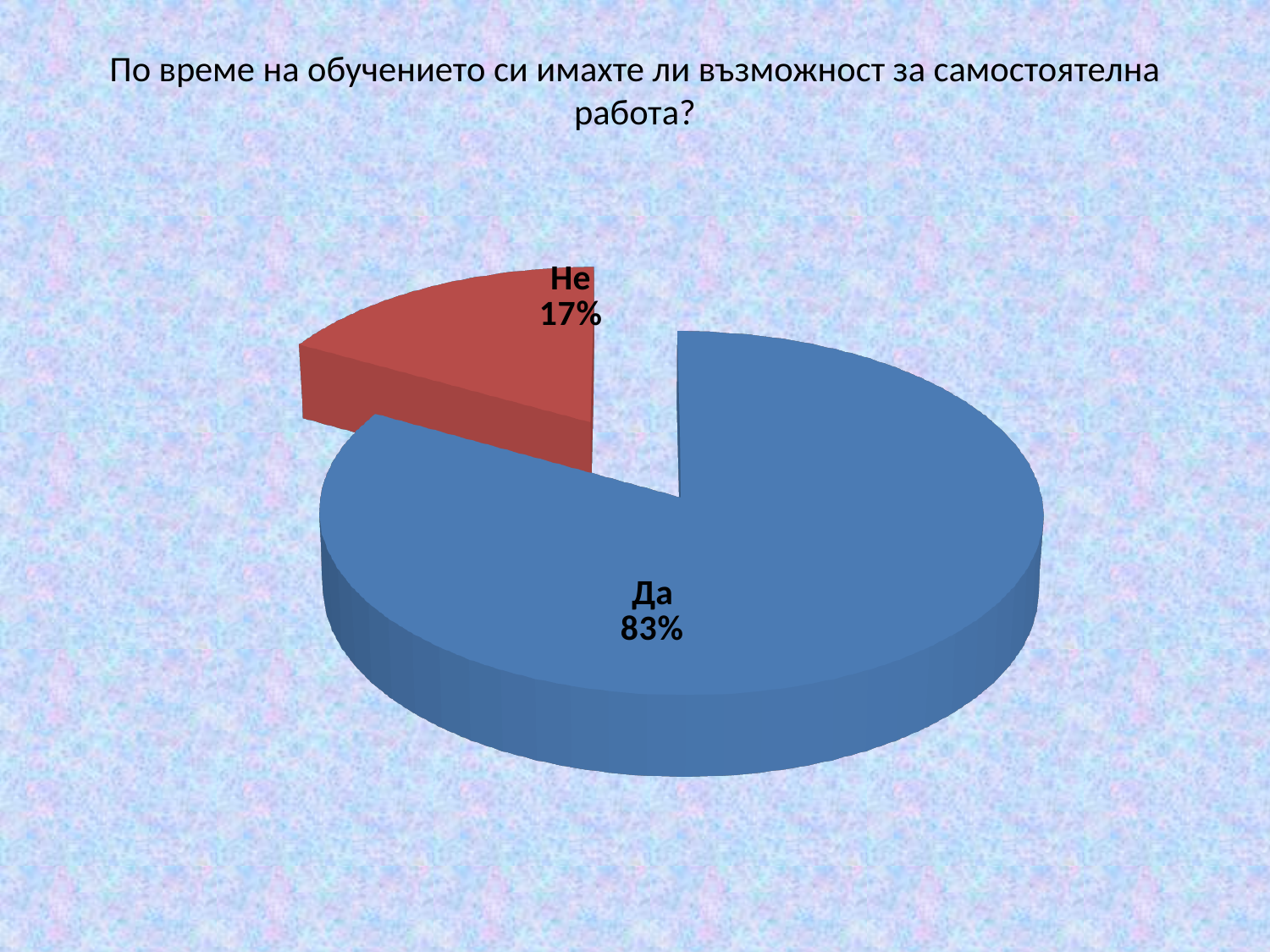
Which is larger, the "Да" slice or the "Не" slice? Да What colour is the "Не" slice? red Which slice of the pie is the largest? Да What percentage of respondents answered "Да"? 83% What kind of chart is shown on the slide? pie chart How many slices does the pie chart have? 2 What share of the pie does the "Не" slice represent? 17% What percentage of respondents answered "Не"? 17% What is the difference in percentage points between the "Да" and "Не" slices? 66 Which slice of the pie is the smallest? Не What colour is the "Да" slice? blue